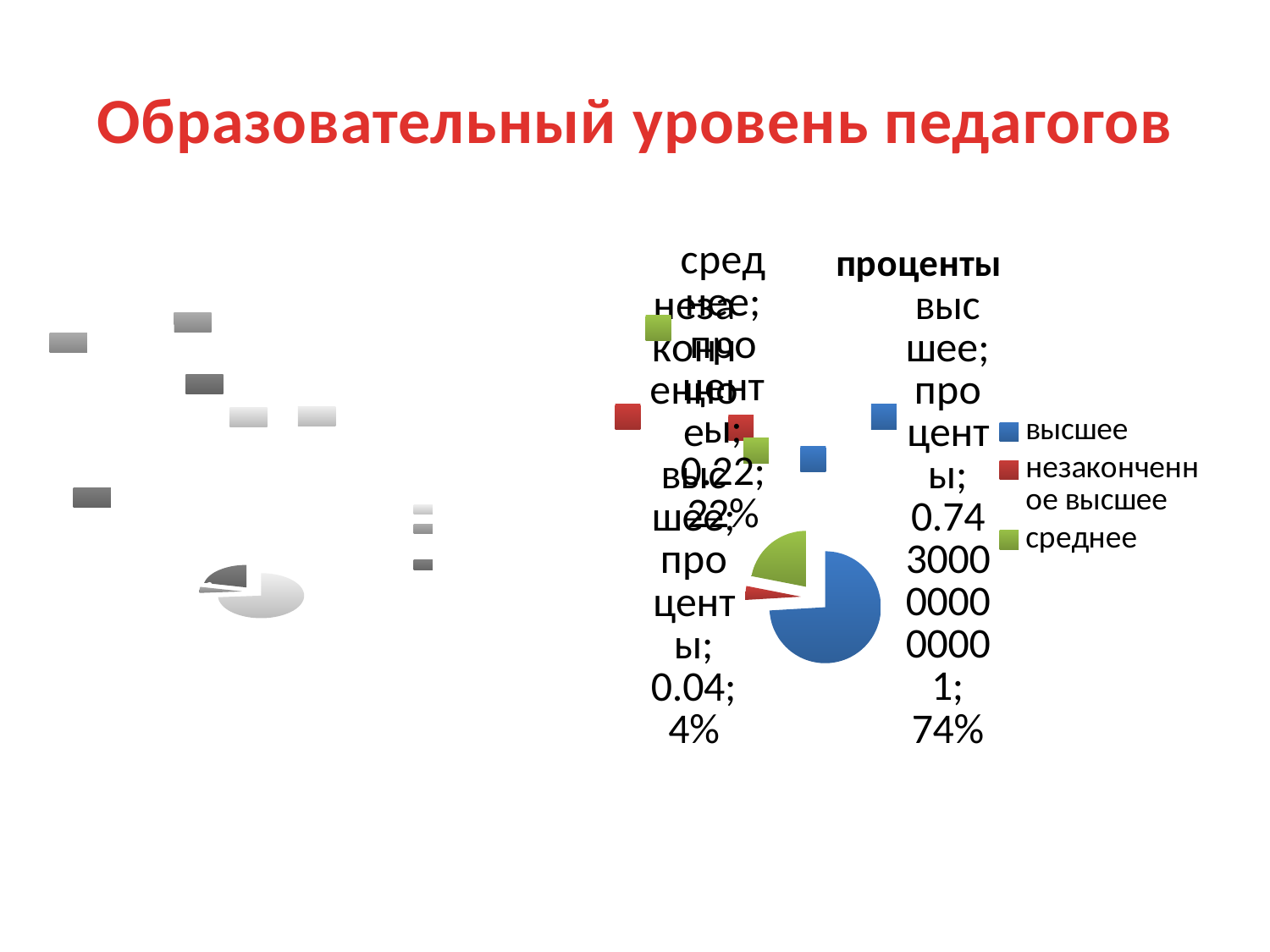
How many slices does the pie chart have? 3 What percentage is shown for среднее in the pie chart? 22% What is the title of the pie chart? проценты By how many percentage points does the share for высшее exceed the share for среднее? 52 Which category has the smallest slice in the pie chart? незаконченное высшее How many categories does the legend of the pie chart list? 3 Which is larger in the pie chart: the slice for среднее or the slice for незаконченное высшее? среднее What kind of chart is shown on the slide? pie chart What percentage is shown for высшее in the pie chart? 74% Which category has the largest slice in the pie chart? высшее What percentage is shown for незаконченное высшее in the pie chart? 4% What colour is the slice for высшее in the pie chart? blue